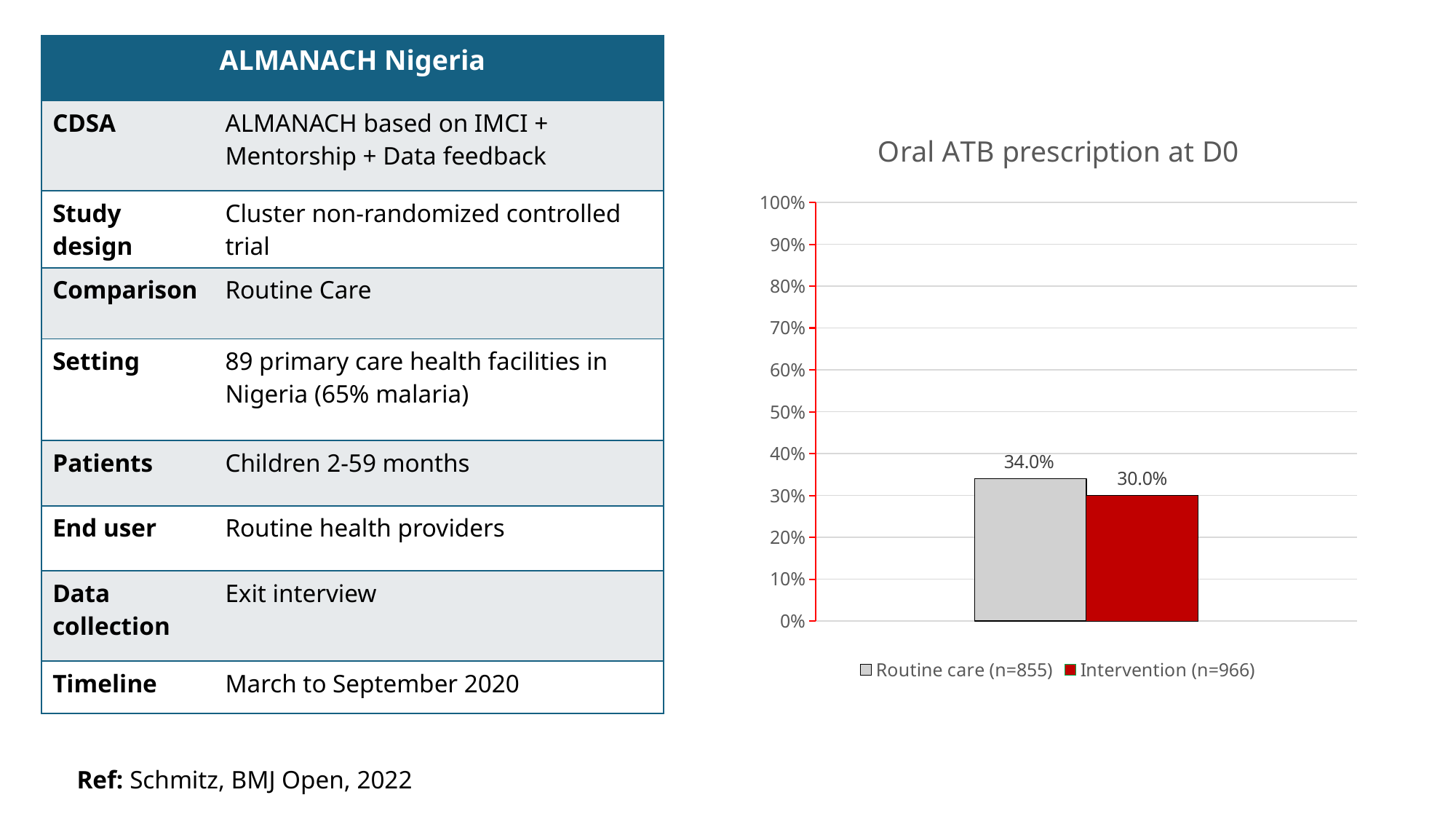
Is the value for Routine care (n=855) greater or less than 30%? greater What is the value for Intervention (n=966) in the Oral ATB prescription at D0 chart? 30.0% Is the value for Routine care (n=855) larger or smaller than the value for Intervention (n=966)? larger What kind of chart is shown on the slide? Bar chart How many series does the legend list in the Oral ATB prescription at D0 chart? 2 Is the value for Intervention (n=966) greater or less than 40%? less What is the value for Routine care (n=855) in the Oral ATB prescription at D0 chart? 34.0% What is the difference between the Routine care and Intervention values in the Oral ATB prescription at D0 chart? 4.0% Which series has the lower value in the Oral ATB prescription at D0 chart? Intervention (n=966) What is the title of the chart on the slide? Oral ATB prescription at D0 Which series has the higher value in the Oral ATB prescription at D0 chart? Routine care (n=855) What colour is the Intervention (n=966) bar in the chart? Red